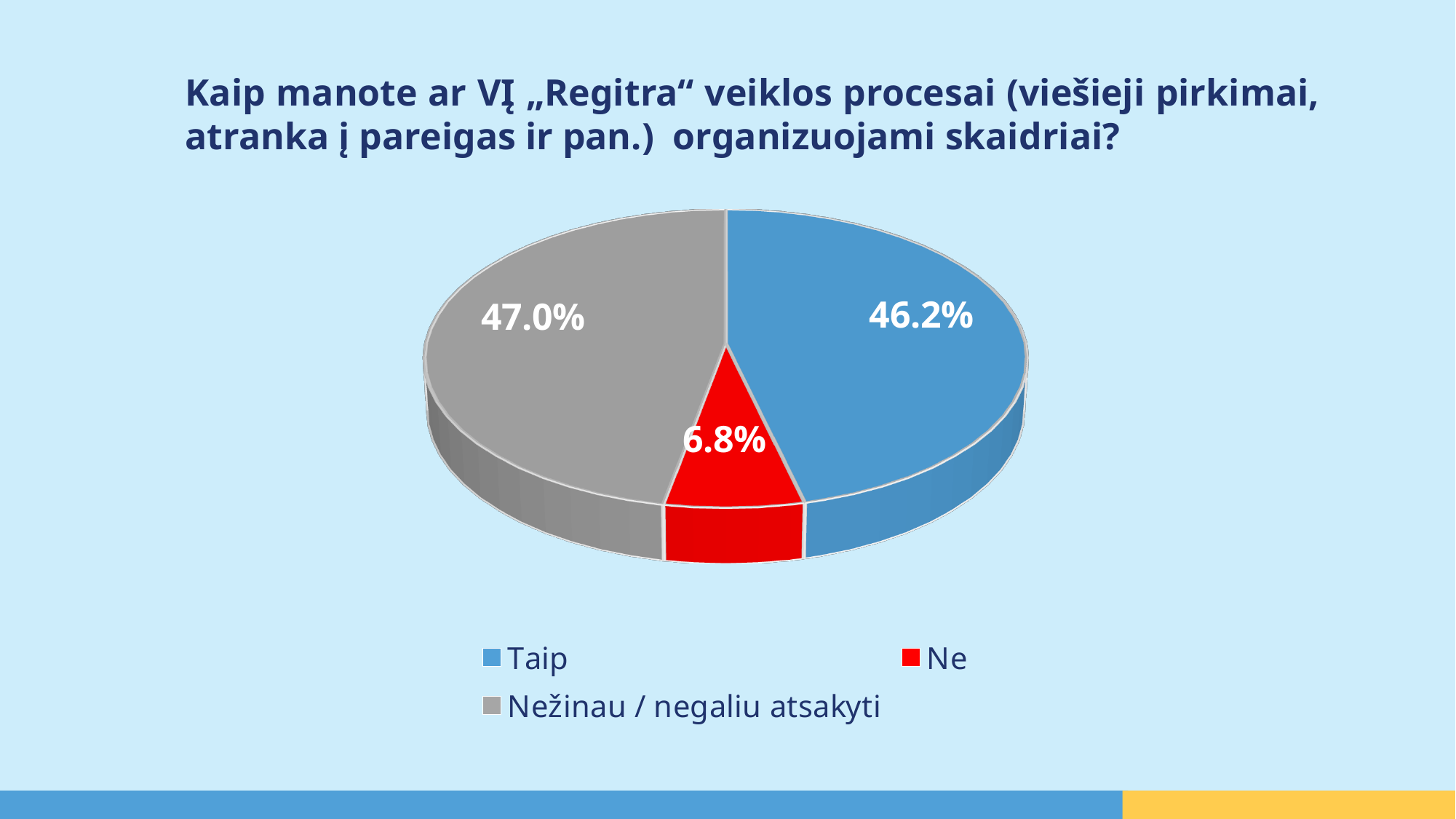
What is the difference between the shares for "Taip" and "Ne"? 39.4% What share of the pie does "Nežinau / negaliu atsakyti" have? 47.0% What is the difference between the shares for "Nežinau / negaliu atsakyti" and "Taip"? 0.8% What share of the pie does "Taip" have? 46.2% How many entries does the legend list? 3 Which legend entry is shown in grey? Nežinau / negaliu atsakyti Which category has the smallest slice of the pie? Ne Which is larger, the share for "Taip" or the share for "Ne"? Taip What share of the pie does "Ne" have? 6.8% What kind of chart is shown on the slide? pie chart How many slices does the pie chart have? 3 What colour is the "Ne" slice in the pie chart? red